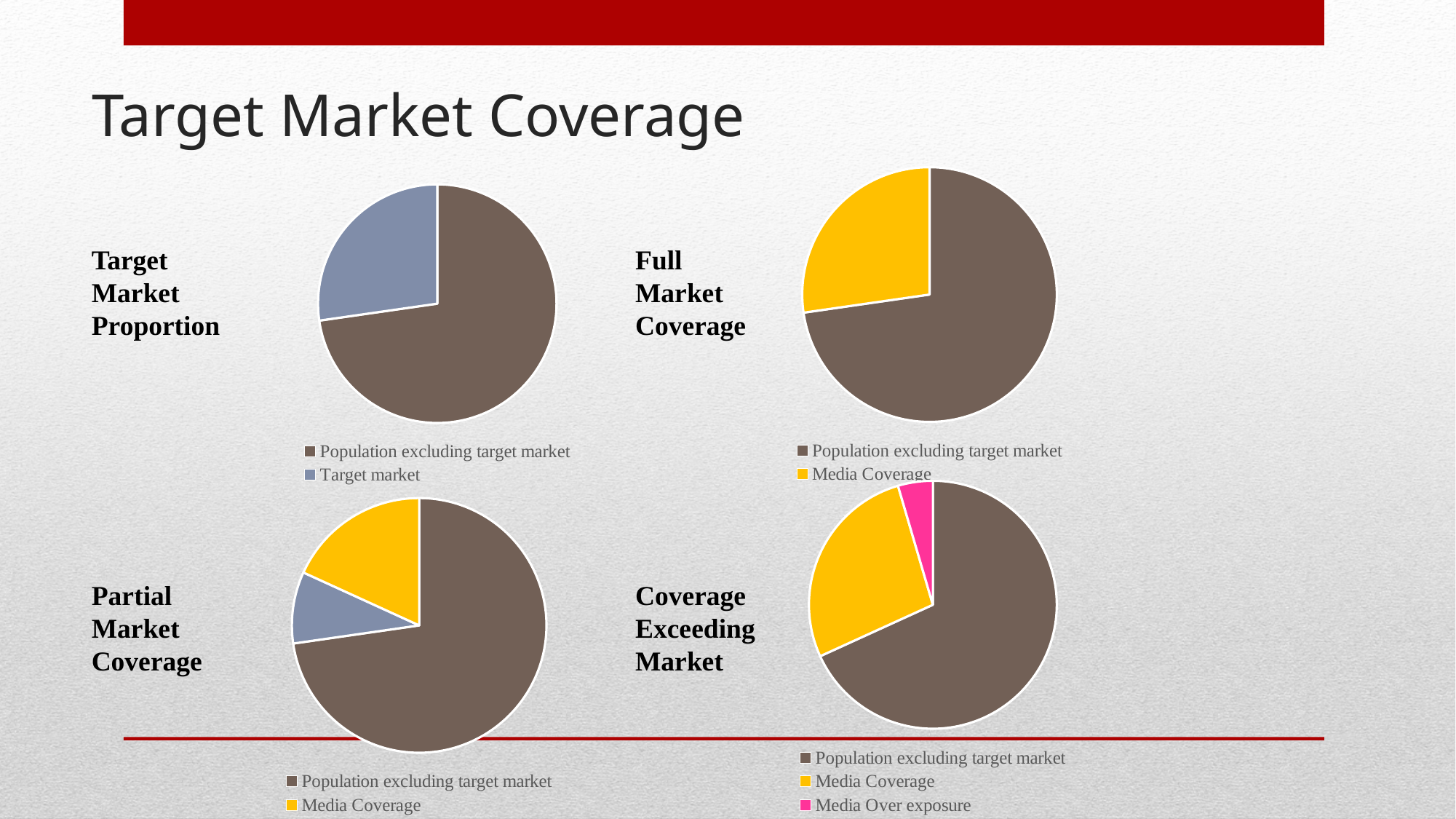
In the Coverage Exceeding Market chart, what colour represents Media Over exposure? Pink In the Coverage Exceeding Market chart, which is larger: Media Coverage or Media Over exposure? Media Coverage In the Partial Market Coverage chart, which slice is the largest? Population excluding target market How many entries does the legend of the Full Market Coverage chart list? 2 In the Target Market Proportion chart, which slice is the smallest? Target market What kind of chart is the Target Market Proportion chart? Pie chart In the Target Market Proportion chart, which slice is the largest? Population excluding target market How many entries does the legend of the Coverage Exceeding Market chart list? 3 In the Coverage Exceeding Market chart, which slice is the smallest? Media Over exposure How many slices does the Partial Market Coverage pie chart have? 3 How many entries does the legend of the Target Market Proportion chart list? 2 In the Full Market Coverage chart, which is larger: Population excluding target market or Media Coverage? Population excluding target market